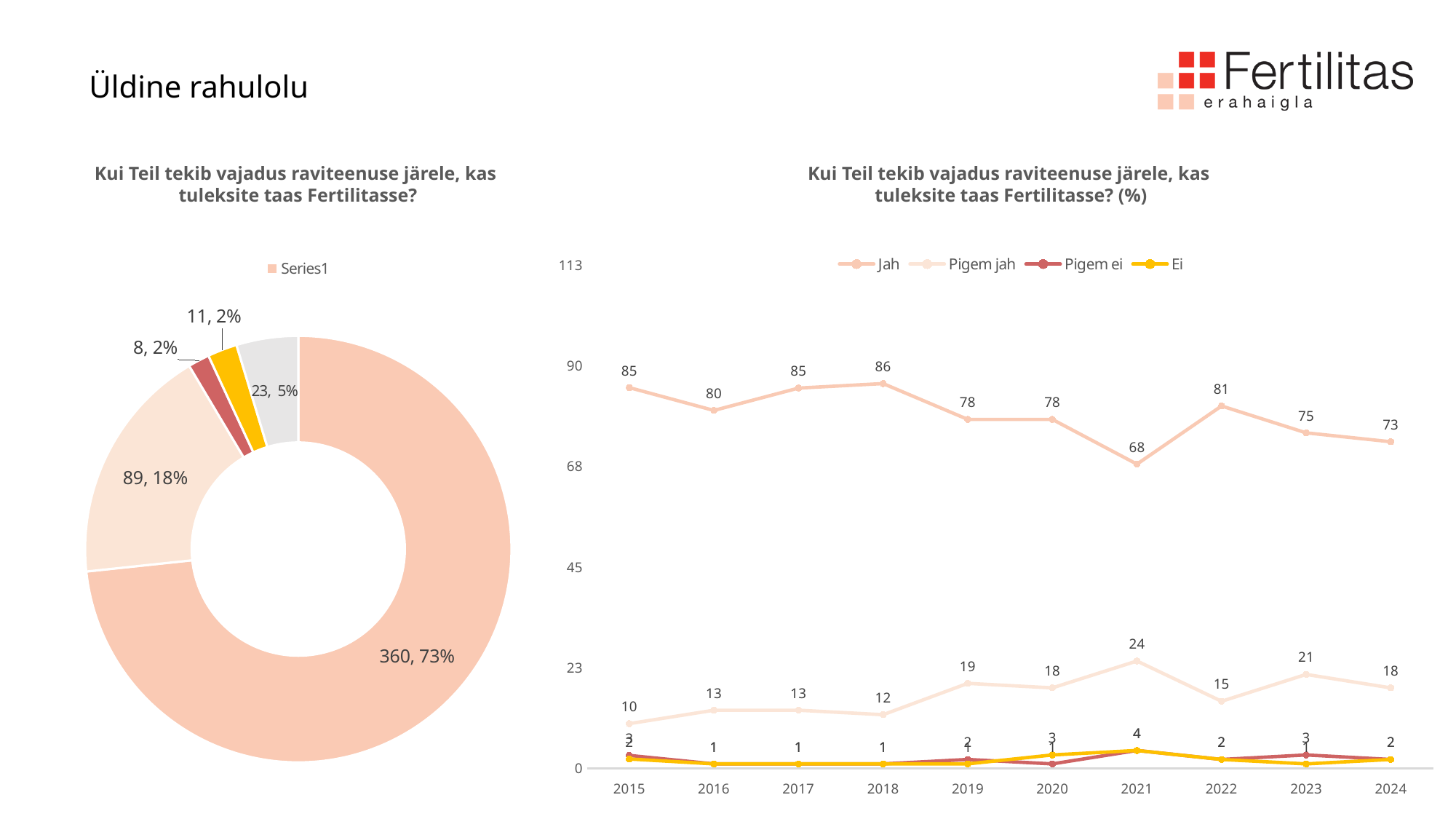
In the right line chart, in which year is the Pigem jah series highest? 2021 What type of chart is the left chart titled "Kui Teil tekib vajadus raviteenuse järele, kas tuleksite taas Fertilitasse?"? Donut (pie) chart In the right line chart, what is the difference between the Jah values in 2015 and 2024? 12 In the right line chart, what is the value of Jah in 2018? 86 In the right line chart, which is larger: Pigem jah in 2019 or Pigem jah in 2022? 2019 How many slices does the left donut chart have? 5 In the left donut chart, what share is shown for the slice with value 89? 18% In the right line chart, in which year is the Jah series lowest? 2021 How many series does the legend of the right line chart list? 4 In the left donut chart, what value and share are shown for the largest slice? 360, 73% What type of chart is the right chart titled "Kui Teil tekib vajadus raviteenuse järele, kas tuleksite taas Fertilitasse? (%)"? Line chart In the left donut chart, what is the value of the grey slice? 23, 5%